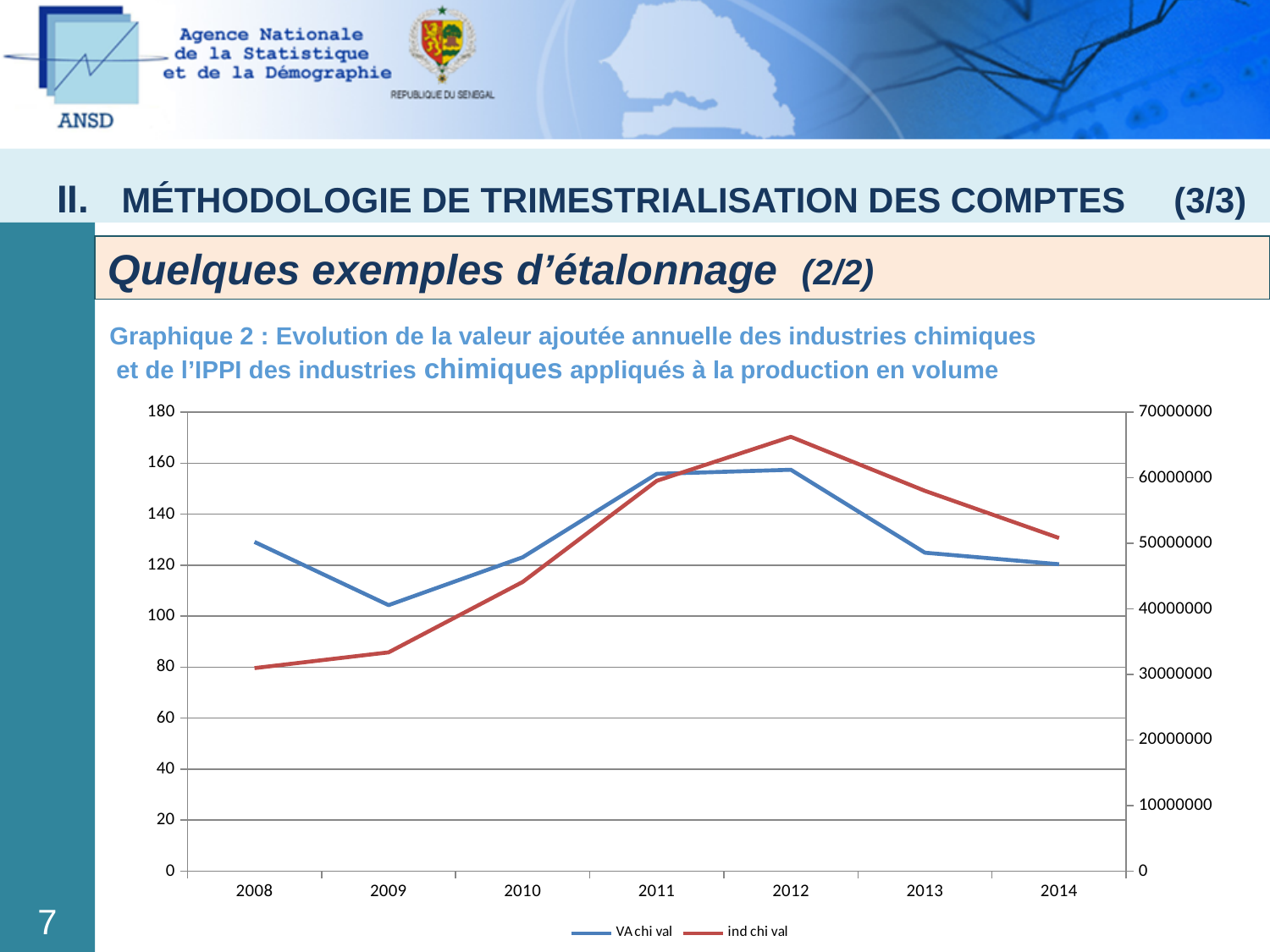
In which year does the 'ind chi val' series reach its highest value? 2012 How many years are plotted along the x axis? 7 Does the 'ind chi val' series rise or fall between 2008 and 2012? rise Does the 'VA chi val' series rise or fall between 2012 and 2014? fall Read against the left-hand axis, is the 'VA chi val' value for 2011 greater or less than 140? greater In which year does the 'ind chi val' series have its lowest value? 2008 Read against the left-hand axis, is the 'ind chi val' value for 2008 greater or less than 100? less Which is larger for the 'ind chi val' series: the value in 2012 or the value in 2014? 2012 In which year does the 'VA chi val' series have its lowest value? 2009 What kind of chart is shown on the slide? line chart What colour is the line for the 'ind chi val' series? red How many series does the legend list? 2